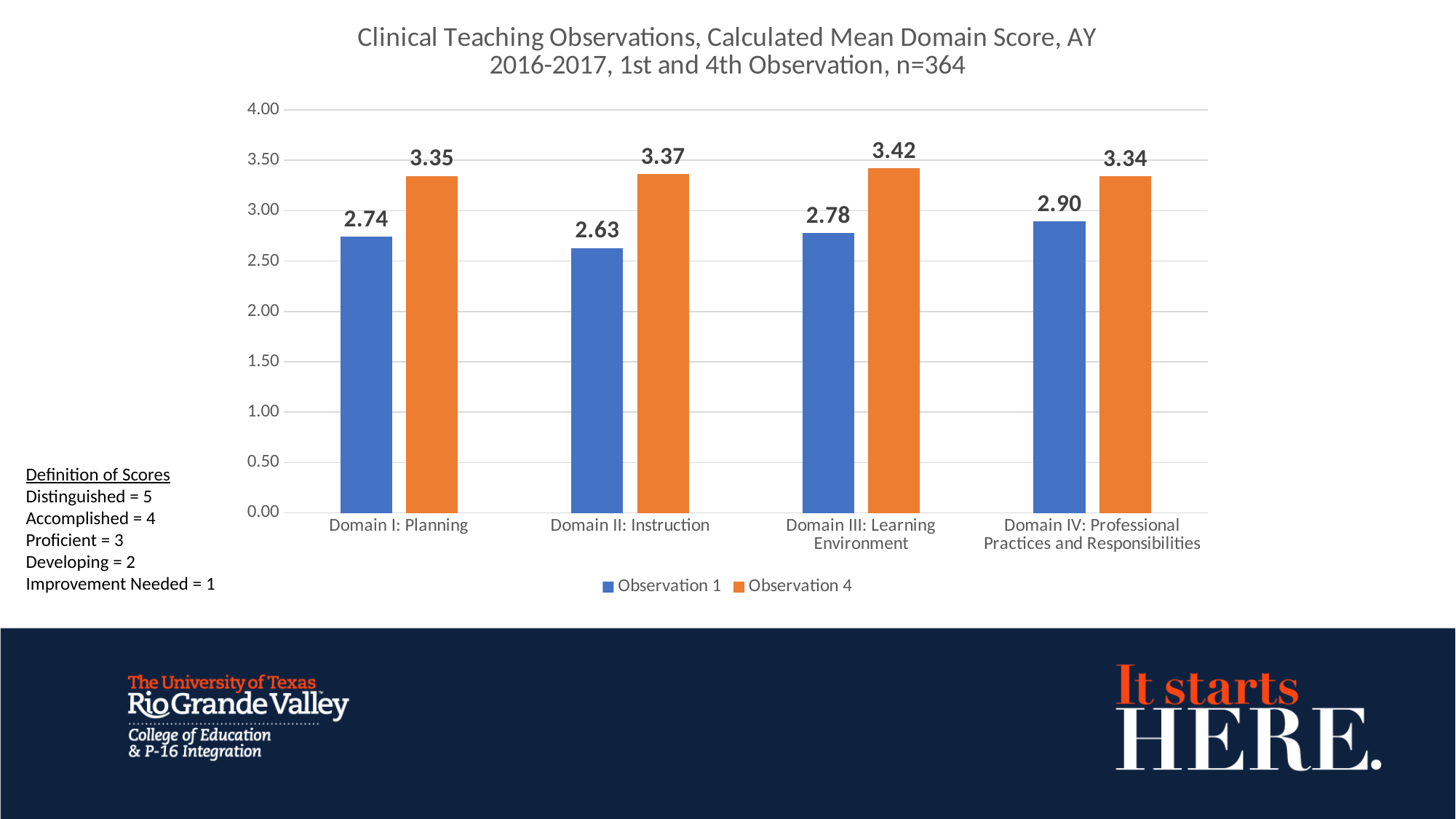
What is the Observation 1 value for Domain I: Planning? 2.74 How many series does the legend list? 2 What is the Observation 4 value for Domain III: Learning Environment? 3.42 What kind of chart is shown on the slide? bar chart Which domain has the lowest Observation 1 value? Domain II: Instruction Which domain has the highest Observation 4 value? Domain III: Learning Environment How many domains are shown on the x axis? 4 Is the Observation 1 value for Domain III: Learning Environment greater or less than 3.00? less What is the Observation 1 value for Domain IV: Professional Practices and Responsibilities? 2.90 What colour are the Observation 4 bars? orange What is the difference between the Observation 4 and Observation 1 values for Domain II: Instruction? 0.74 Which is larger for Domain I: Planning, the Observation 1 value or the Observation 4 value? Observation 4